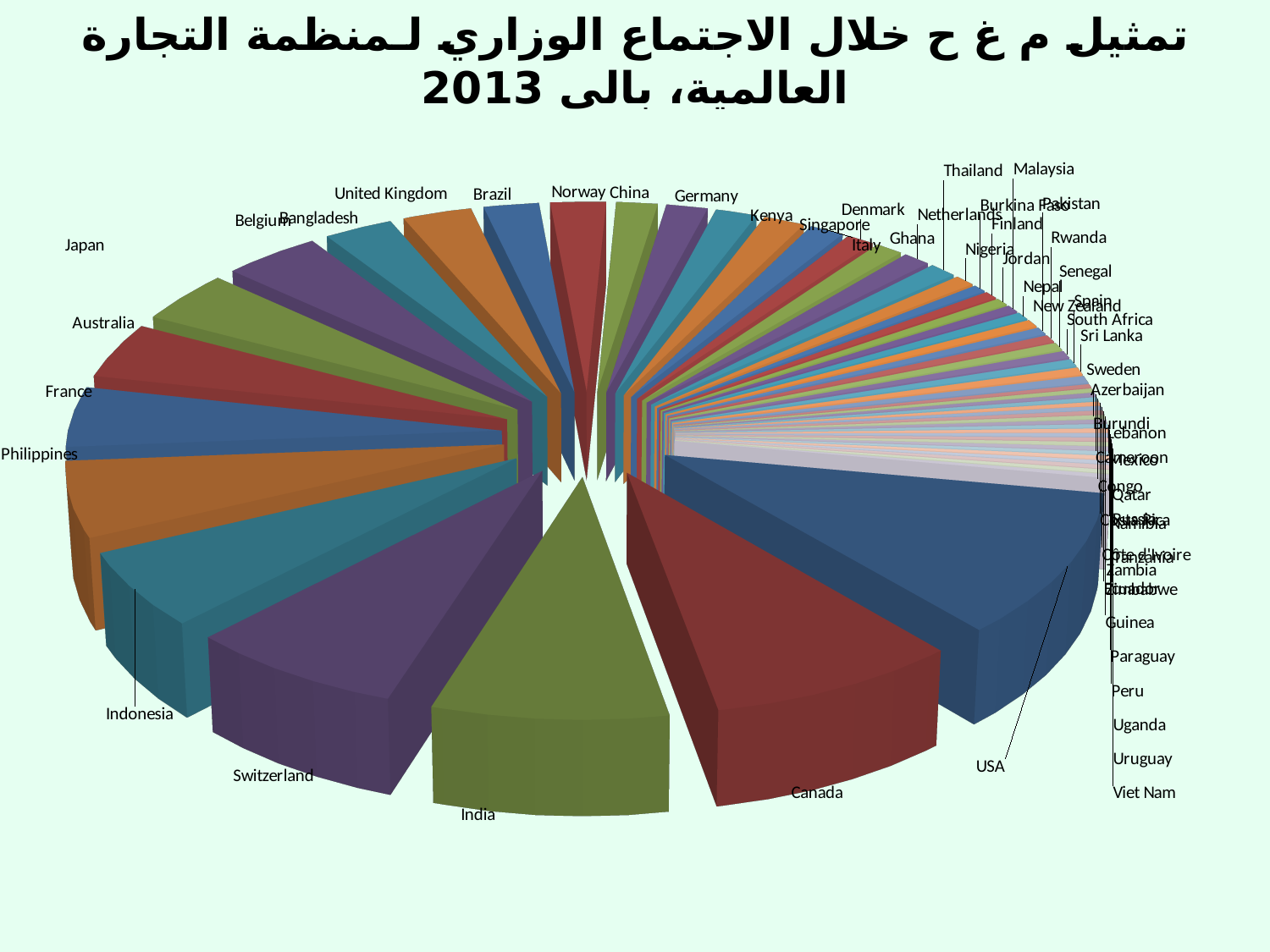
What colour is the India slice? green Which slice is larger, Switzerland or Brazil? Switzerland Which slice is larger, Indonesia or Germany? Indonesia Among USA, Japan and Norway, which slice is the largest? USA What kind of chart is shown on the slide? pie chart Which slice is larger, USA or Japan? USA Which year is mentioned in the chart title? 2013